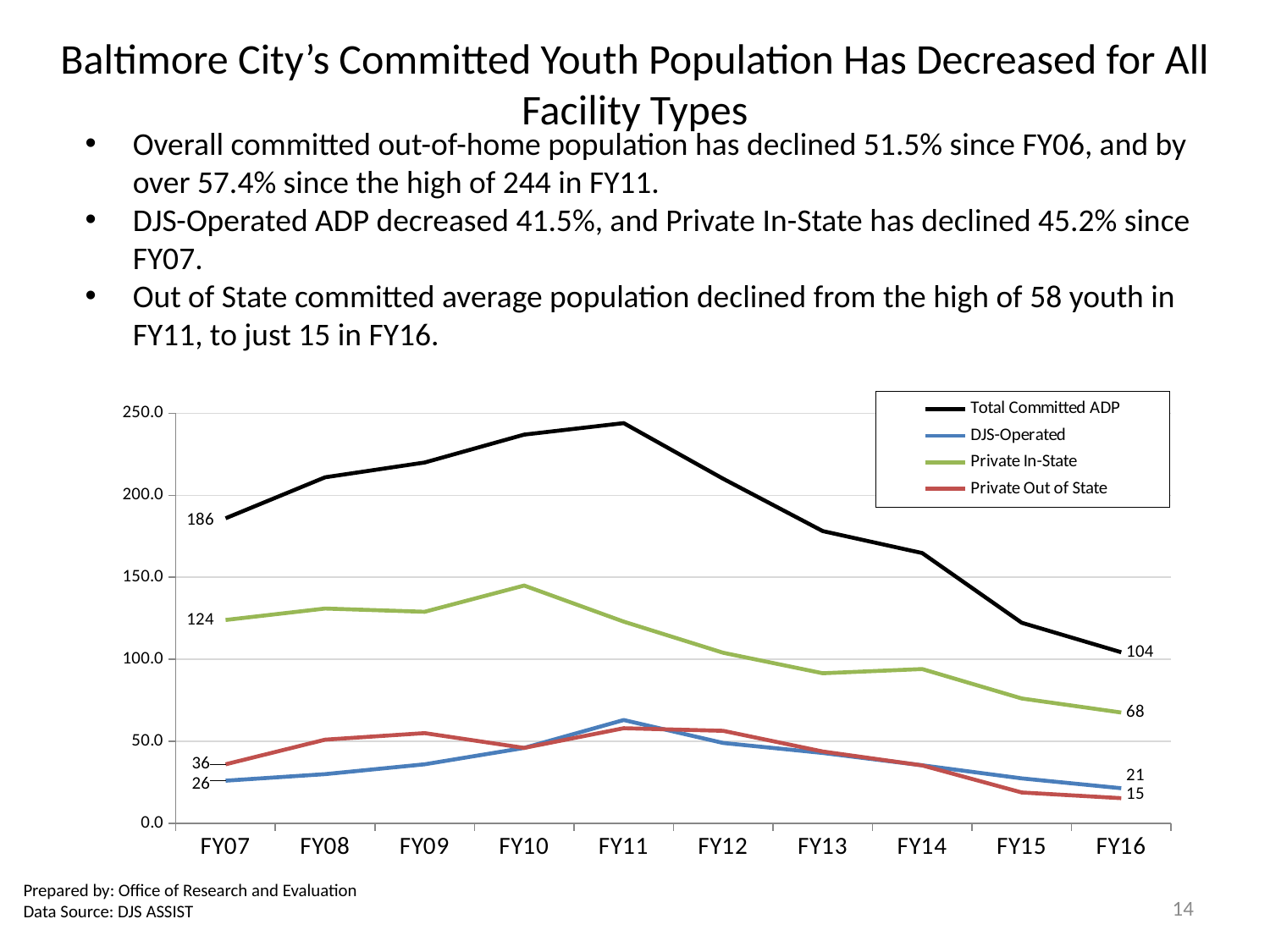
Which is larger in FY07, the Private Out of State value or the DJS-Operated value? Private Out of State What is the Private In-State value for FY16? 68 How many fiscal years are plotted along the x axis? 10 Does the Total Committed ADP line rise or fall from FY11 to FY16? fall What is the Total Committed ADP value for FY07? 186 What type of chart is shown on the slide? line chart What is the Total Committed ADP value for FY16? 104 What is the DJS-Operated value for FY07? 26 How many series does the legend list? 4 Is the Total Committed ADP value for FY11 greater or less than 200.0? greater By how much did Total Committed ADP fall from FY07 to FY16? 82 What is the Private Out of State value for FY16? 15